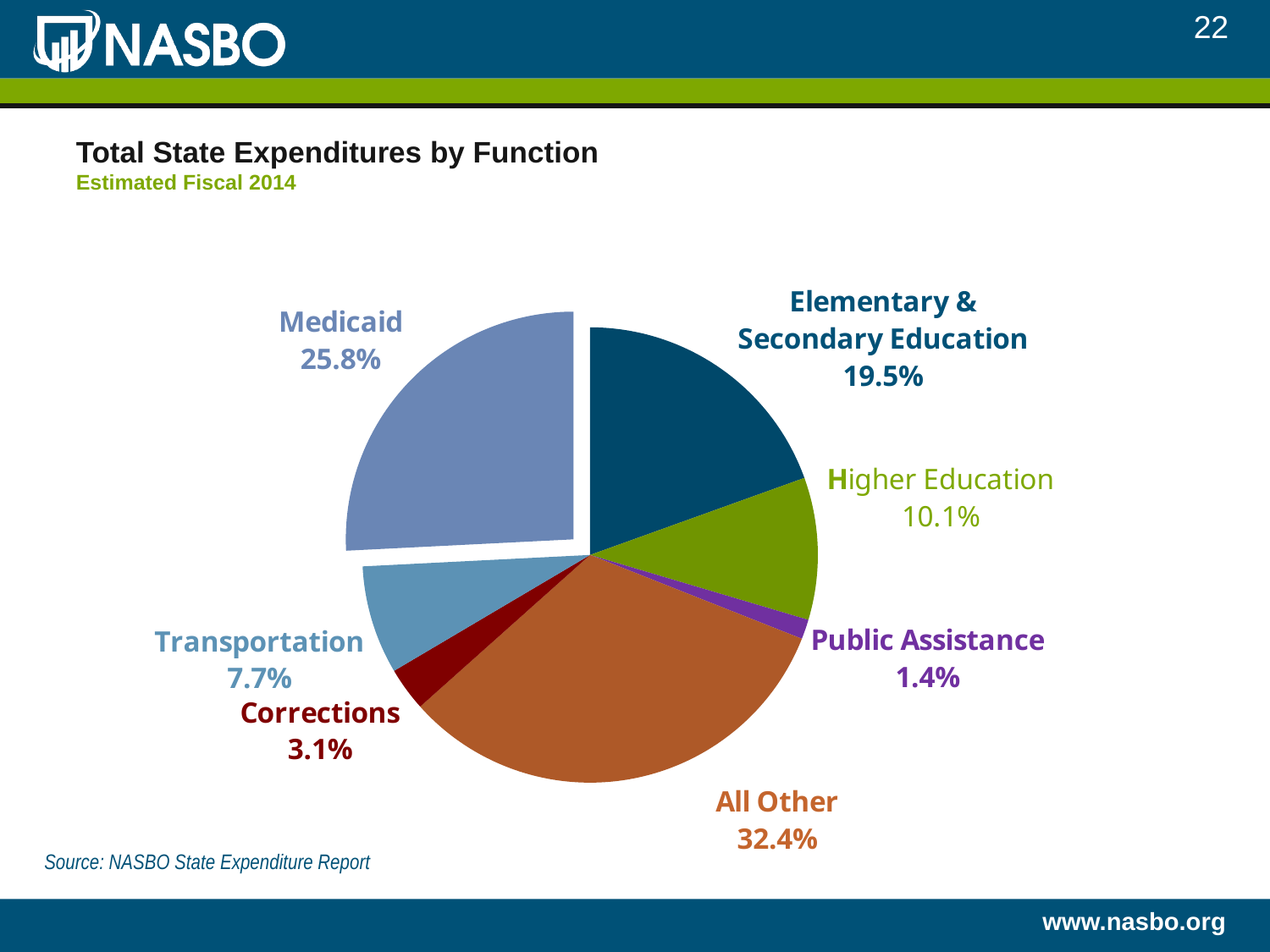
What is the combined share of Higher Education and Public Assistance? 11.5% What share of total state expenditures goes to Corrections? 3.1% What is the difference in percentage points between Medicaid and Elementary & Secondary Education? 6.3 What share of total state expenditures goes to Medicaid? 25.8% How many slices does the pie chart have? 7 Which is larger, the share for Transportation or the share for Corrections? Transportation What type of chart is shown on the slide? pie chart What share of total state expenditures goes to Elementary & Secondary Education? 19.5% What share of total state expenditures goes to Higher Education? 10.1% What fiscal year does the chart's subtitle refer to? Estimated Fiscal 2014 Which function has the smallest share of total state expenditures? Public Assistance Which function has the largest share of total state expenditures? All Other